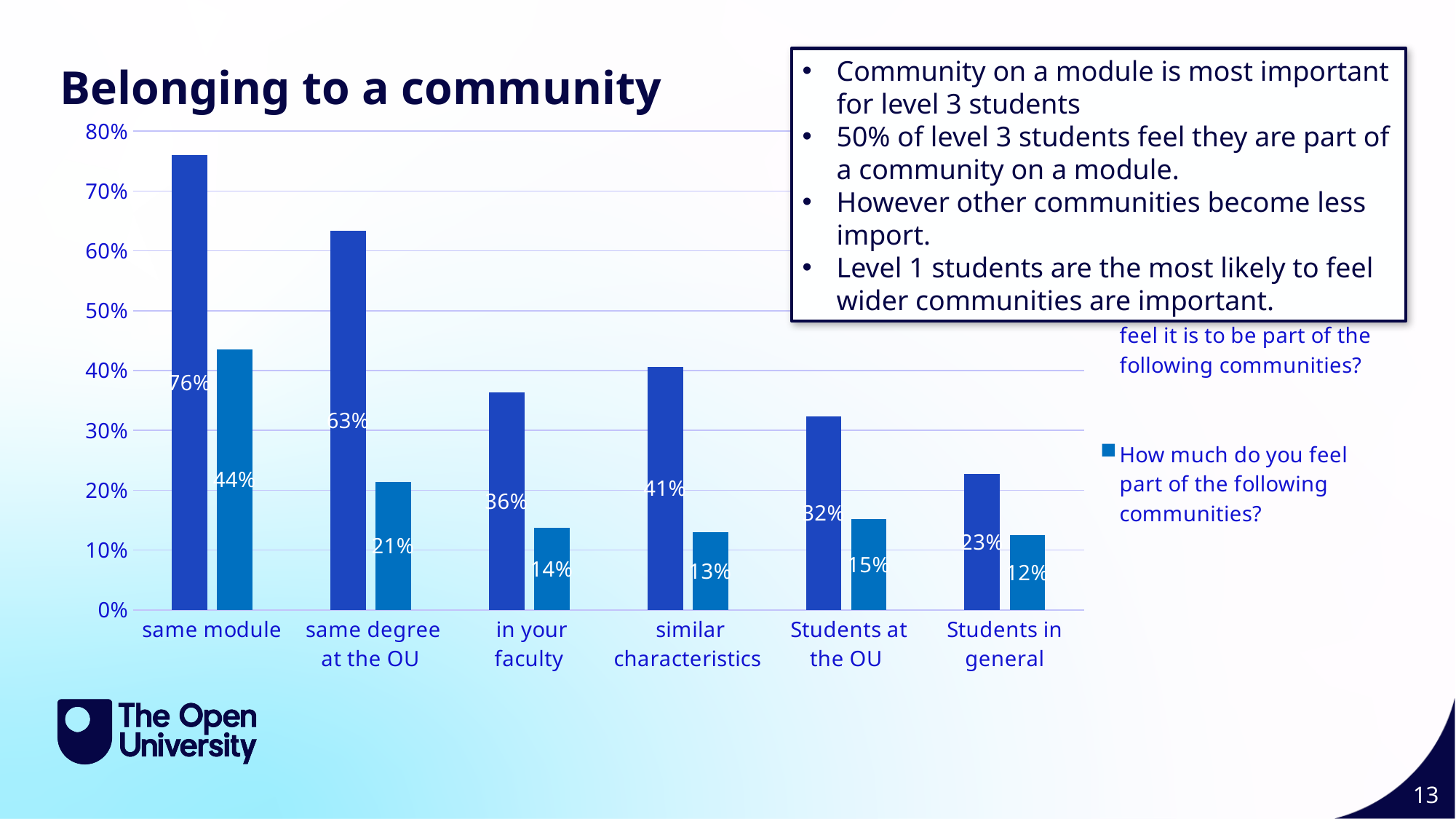
What is the value of the dark blue bar for "similar characteristics"? 41% In the "How much do you feel part of the following communities?" series, what is the value for "same degree at the OU"? 21% In the "How much do you feel part of the following communities?" series, what is the value for "Students at the OU"? 15% Which is larger: the dark blue bar for "in your faculty" or the dark blue bar for "similar characteristics"? similar characteristics Do the values of the dark blue bars generally rise or fall from "same module" to "Students in general"? fall What kind of chart is shown on the slide? bar chart How many categories are shown on the x axis of the chart? 6 Is the dark blue bar for "same degree at the OU" greater or less than 60%? greater What is the value of the dark blue bar for "same module"? 76% Which category has the highest dark blue bar? same module Which category has the lowest value in the "How much do you feel part of the following communities?" series? Students in general What is the difference between the dark blue bar and the light blue bar for "same module"? 32%